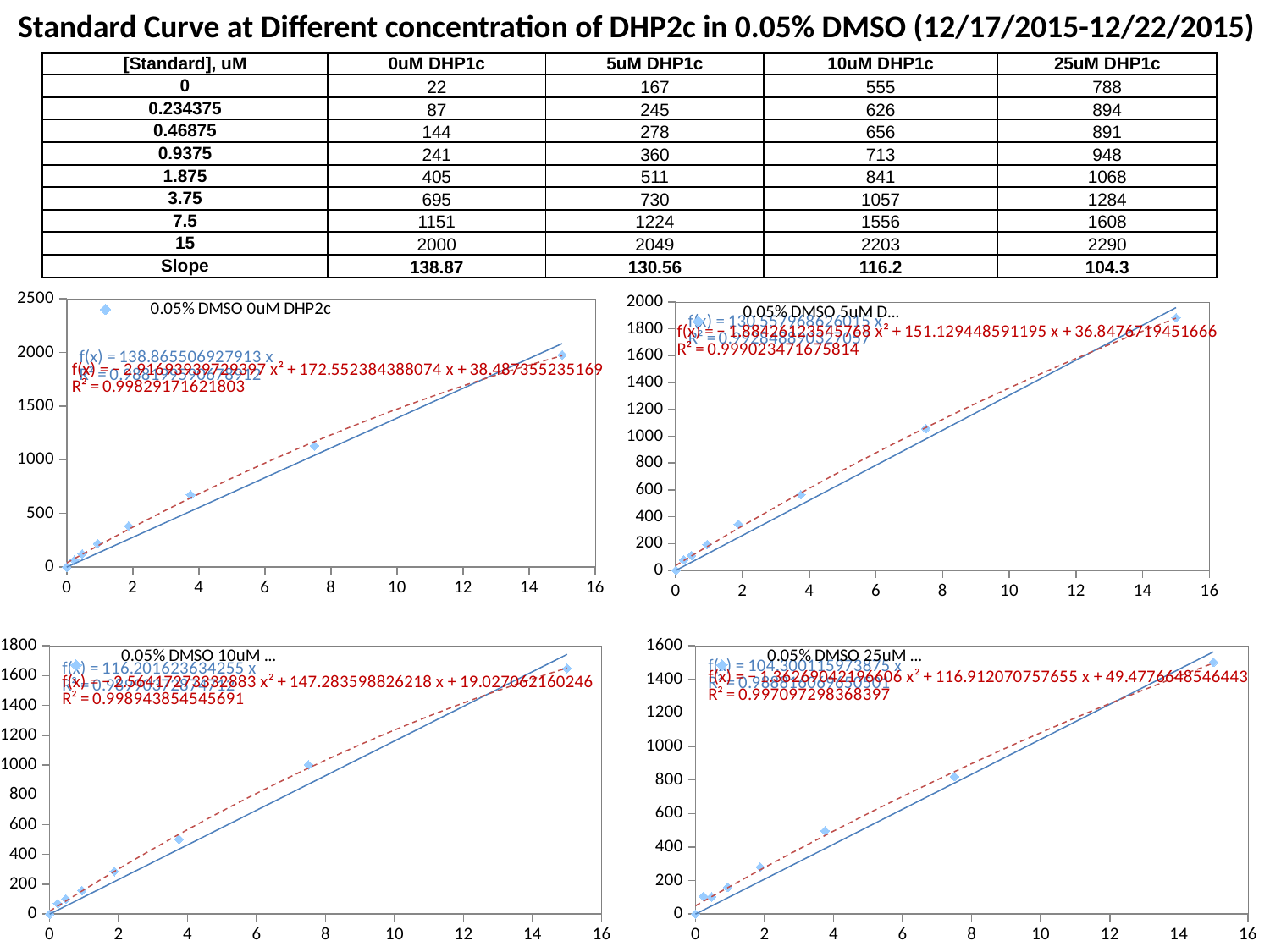
What is the maximum value shown on the y axis of the top-left chart? 2500 In the top-left chart, do the plotted values rise or fall as the x value increases? rise What is the legend label shown in the top-left chart? 0.05% DMSO 0uM DHP2c In the bottom-left chart, is the value at x = 1.875 greater or less than 400? less In the top-right chart, is the value at x = 3.75 greater or less than 800? less What kind of chart is the top-left chart on the slide? scatter chart In the top-right chart, is the value at x = 15 greater or less than 1600? greater At which x value does the bottom-right chart reach its highest plotted value? 15